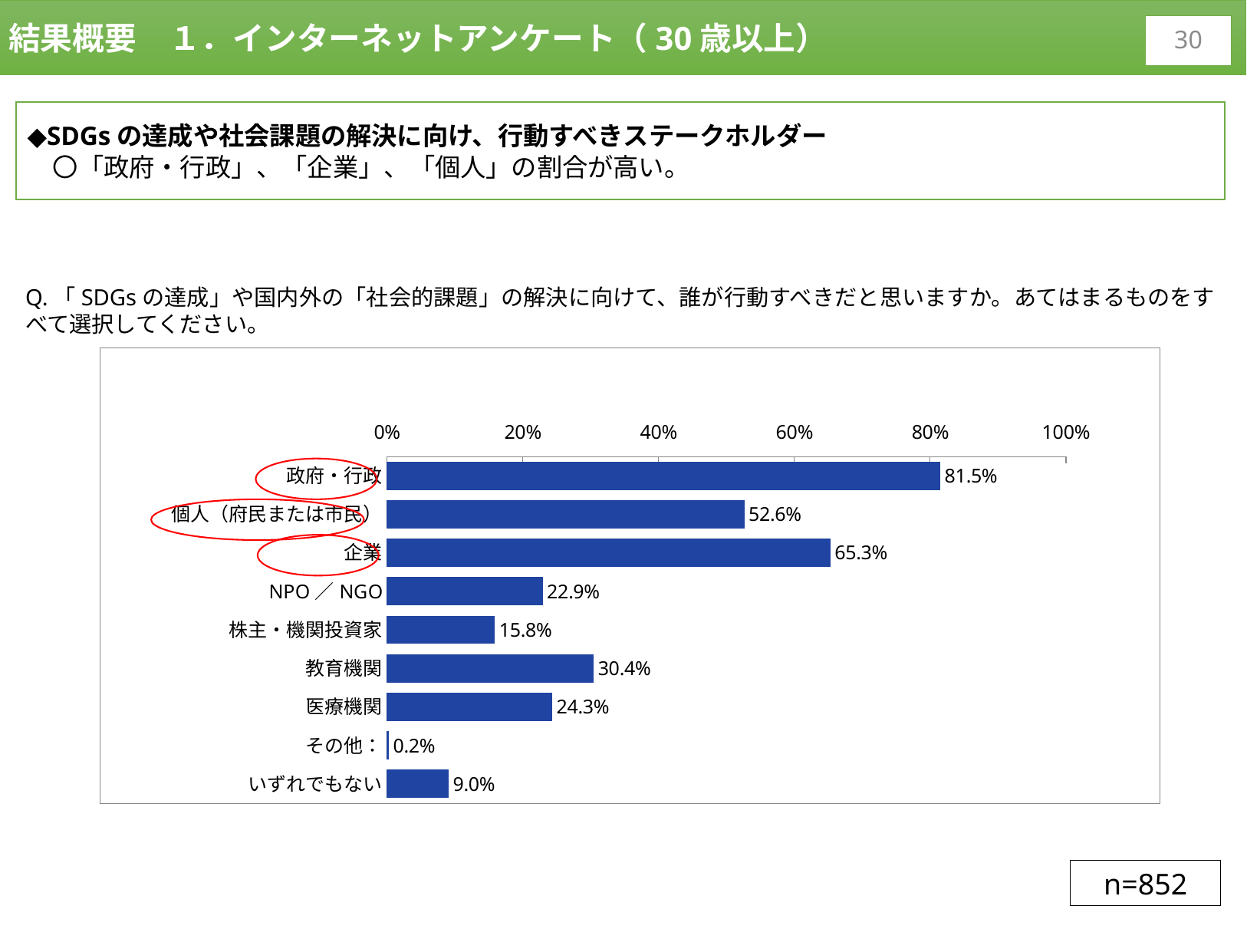
What is the value for 個人（府民または市民）? 52.6% Which is larger, the value for NPO／NGO or the value for 医療機関? 医療機関 Which category has the highest value? 政府・行政 What is the difference between the values for 政府・行政 and 企業? 16.2% What is the sample size shown on the slide? n=852 What kind of chart is shown on the slide? Bar chart How many categories are shown in the chart? 9 What is the value for 教育機関? 30.4% What is the value for その他：? 0.2% Which category has the lowest value? その他： What is the value for 企業? 65.3% What is the value for 政府・行政? 81.5%